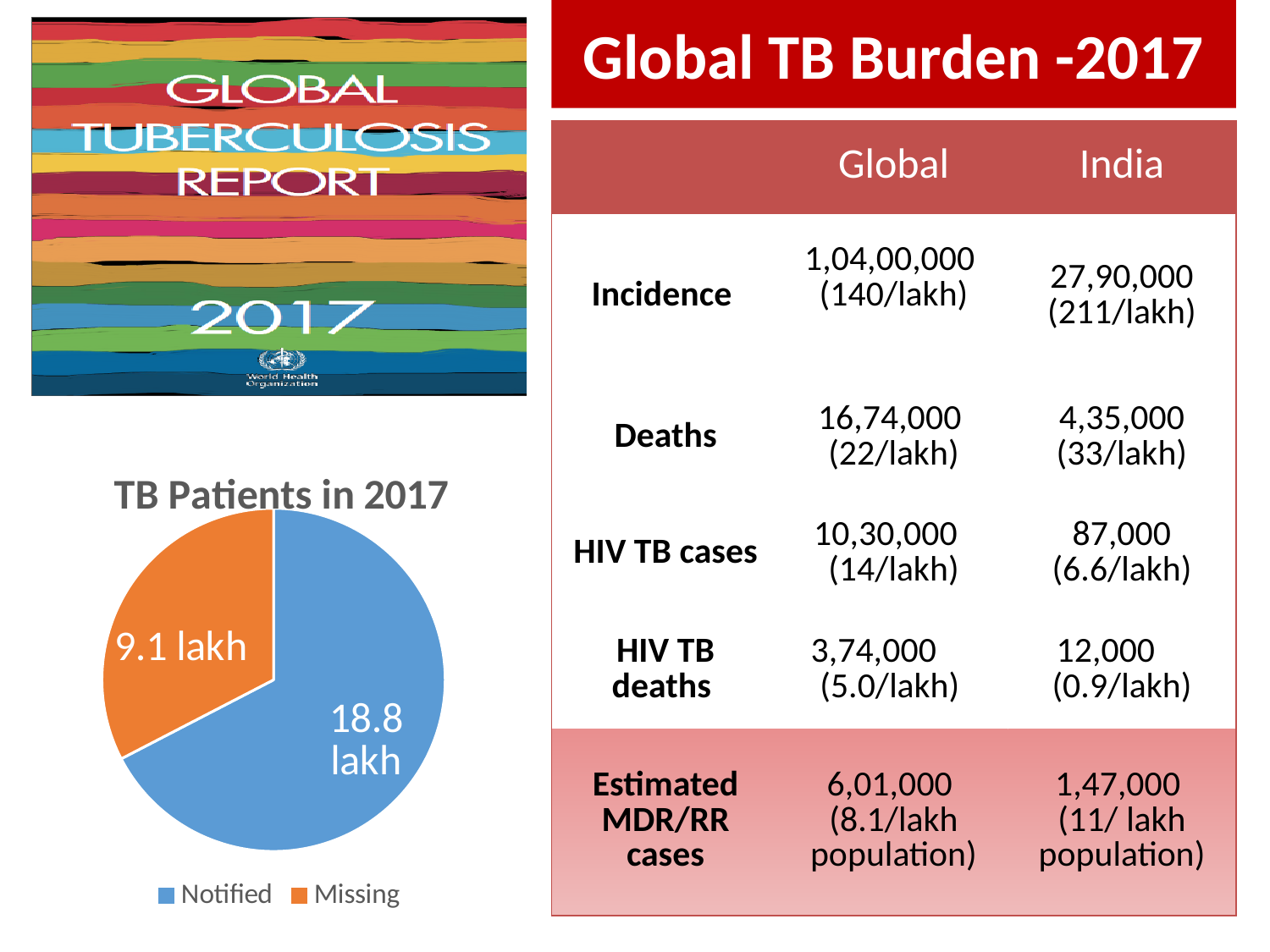
What is the value of the Notified slice in the pie chart? 18.8 lakh What kind of chart is shown on the slide? pie chart How many slices does the pie chart have? 2 What is the title of the pie chart? TB Patients in 2017 What is the difference between the Notified and Missing values in the pie chart? 9.7 lakh Which colour represents the Missing slice in the pie chart? orange Which slice of the pie chart is the largest? Notified Which is larger in the pie chart, Notified or Missing? Notified Which slice of the pie chart is the smallest? Missing How many entries does the pie chart's legend list? 2 What is the total of the two slices in the pie chart? 27.9 lakh What is the value of the Missing slice in the pie chart? 9.1 lakh